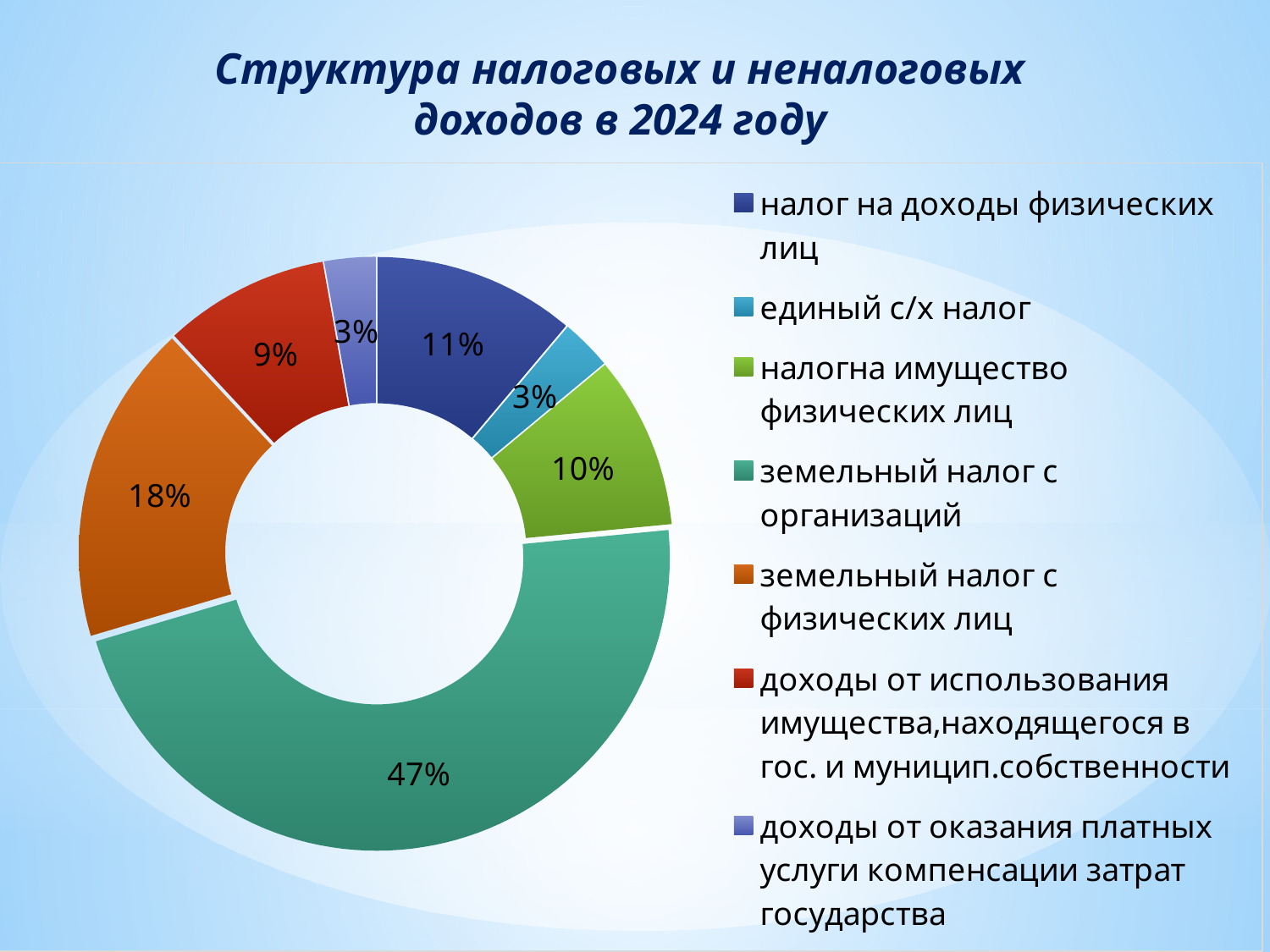
Which is larger: налог на доходы физических лиц or налог на имущество физических лиц? налог на доходы физических лиц What is the title of the chart on the slide? Структура налоговых и неналоговых доходов в 2024 году What percentage is shown for земельный налог с физических лиц? 18% What is the difference between the shares of земельный налог с организаций and земельный налог с физических лиц? 29% What type of chart is shown on the slide? doughnut chart What is the value for доходы от использования имущества, находящегося в гос. и муницип. собственности? 9% What colour is the slice for земельный налог с физических лиц? orange What is the value shown for налог на доходы физических лиц? 11% What share of the chart does земельный налог с организаций account for? 47% What is the value for единый с/х налог? 3% Which category has the largest share of the chart? земельный налог с организаций How many categories does the chart show? 7